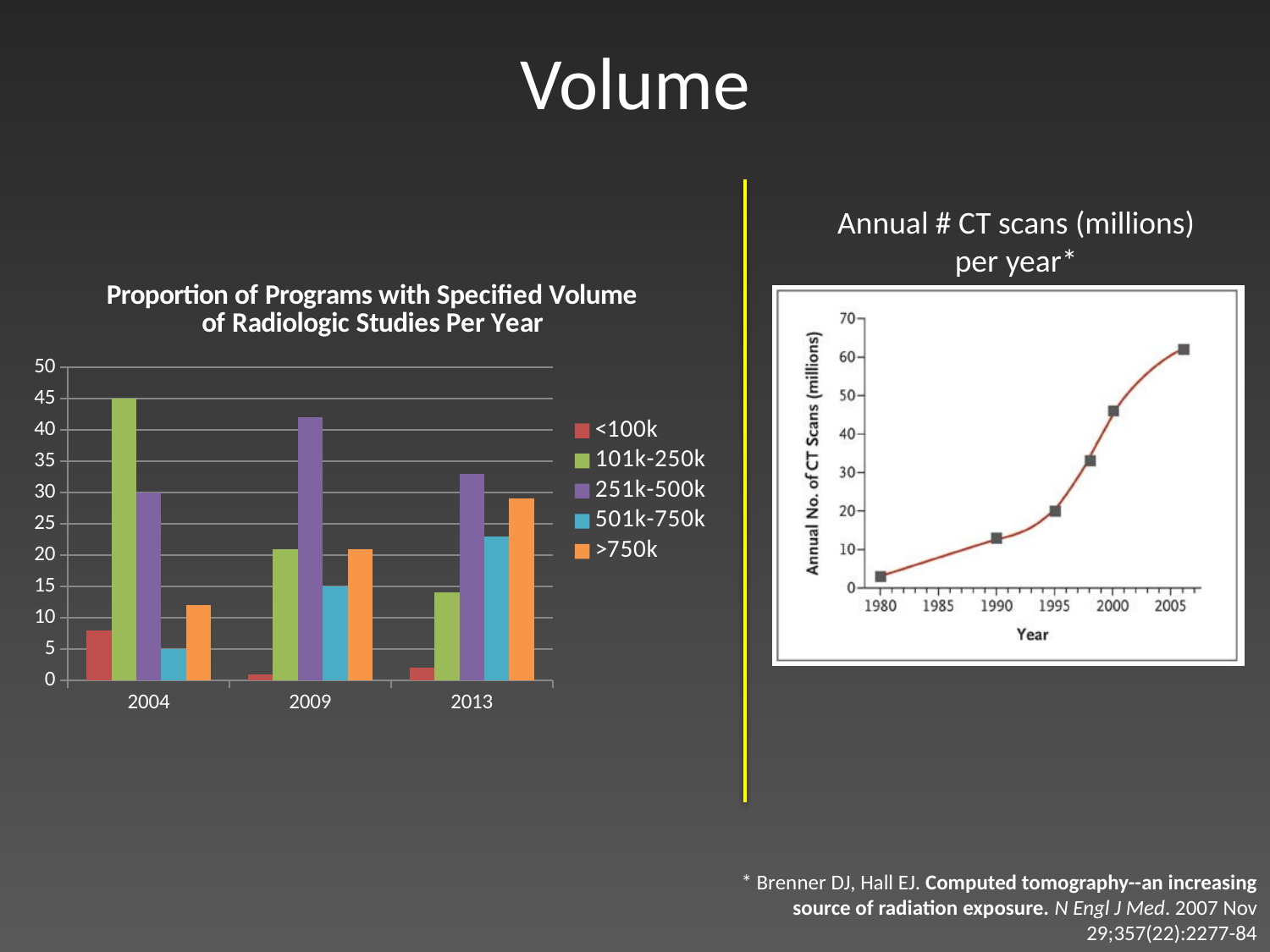
What kind of chart is the 'Annual # CT scans (millions) per year' chart? line chart In the 'Annual # CT scans (millions) per year' chart, do the values rise or fall from 1980 to 2005? rise In the 'Proportion of Programs with Specified Volume of Radiologic Studies Per Year' chart, what is the value for 101k-250k in 2004? 45 What kind of chart is the 'Proportion of Programs with Specified Volume of Radiologic Studies Per Year' chart? bar chart How many series does the legend of the 'Proportion of Programs with Specified Volume of Radiologic Studies Per Year' chart list? 5 In the 'Proportion of Programs with Specified Volume of Radiologic Studies Per Year' chart, which volume category has the highest value in 2004? 101k-250k In the 'Proportion of Programs with Specified Volume of Radiologic Studies Per Year' chart, is the value for >750k in 2013 greater or less than 25? greater In the 'Proportion of Programs with Specified Volume of Radiologic Studies Per Year' chart, is the value for 501k-750k larger in 2004 or in 2013? 2013 In the 'Proportion of Programs with Specified Volume of Radiologic Studies Per Year' chart, which volume category has the highest value in 2009? 251k-500k How many years are shown on the x axis of the 'Proportion of Programs with Specified Volume of Radiologic Studies Per Year' chart? 3 In the 'Proportion of Programs with Specified Volume of Radiologic Studies Per Year' chart, does the value for 101k-250k rise or fall from 2004 to 2013? fall In the 'Annual # CT scans (millions) per year' chart, is the value for the last plotted point (after 2005) greater or less than 60? greater